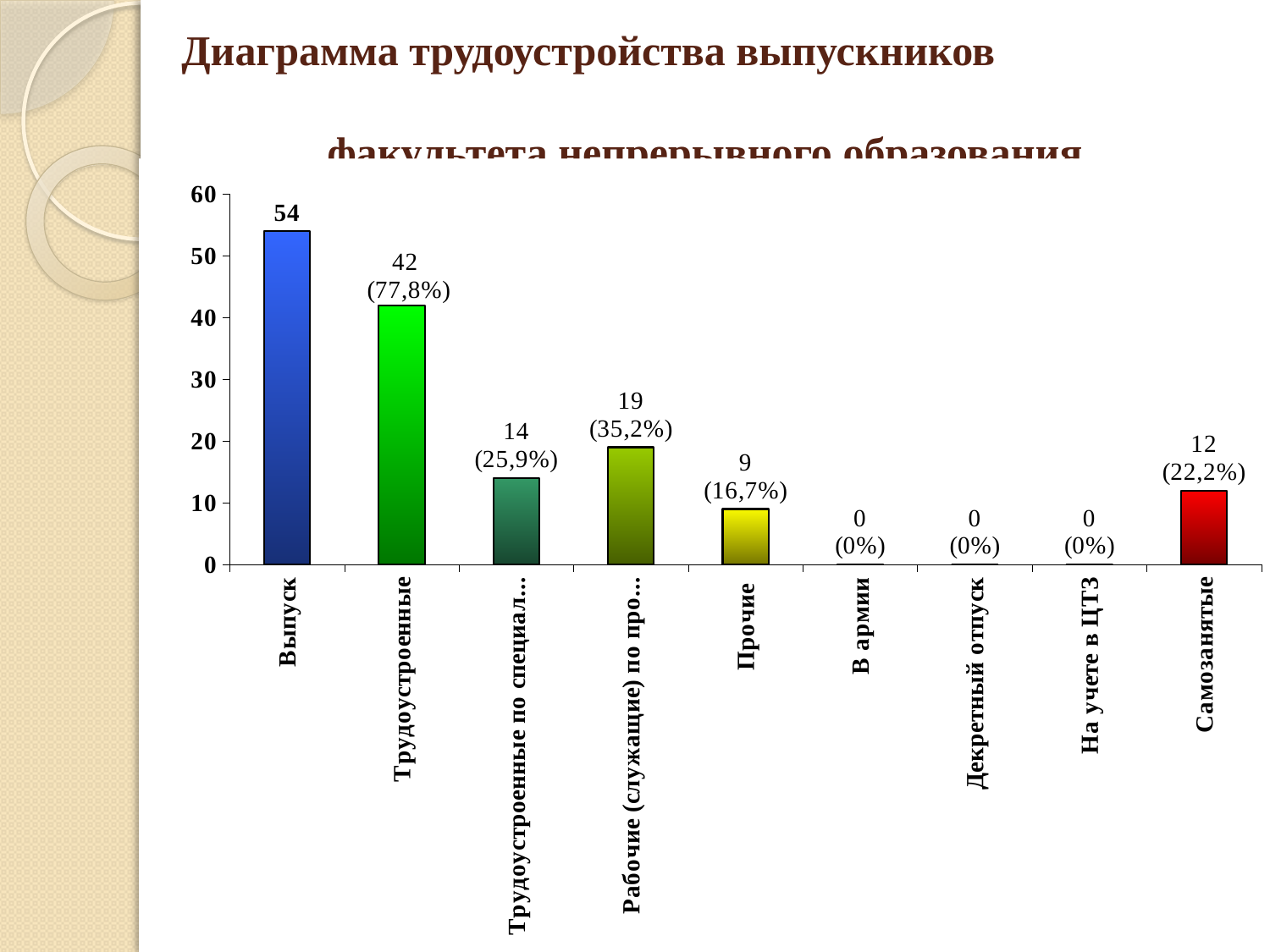
What percentage is shown for Самозанятые? 22,2% Which is larger, the value for Самозанятые or the value for Прочие? Самозанятые What percentage is shown for Прочие? 16,7% What is the value for В армии? 0 What is the value for Трудоустроенные? 42 How many categories are shown on the x axis? 9 What kind of chart is shown on the slide? Bar chart What is the value for Прочие? 9 How many categories have a value of 0? 3 What is the value for Выпуск? 54 What is the difference between the values for Выпуск and Трудоустроенные? 12 Which category has the highest value? Выпуск